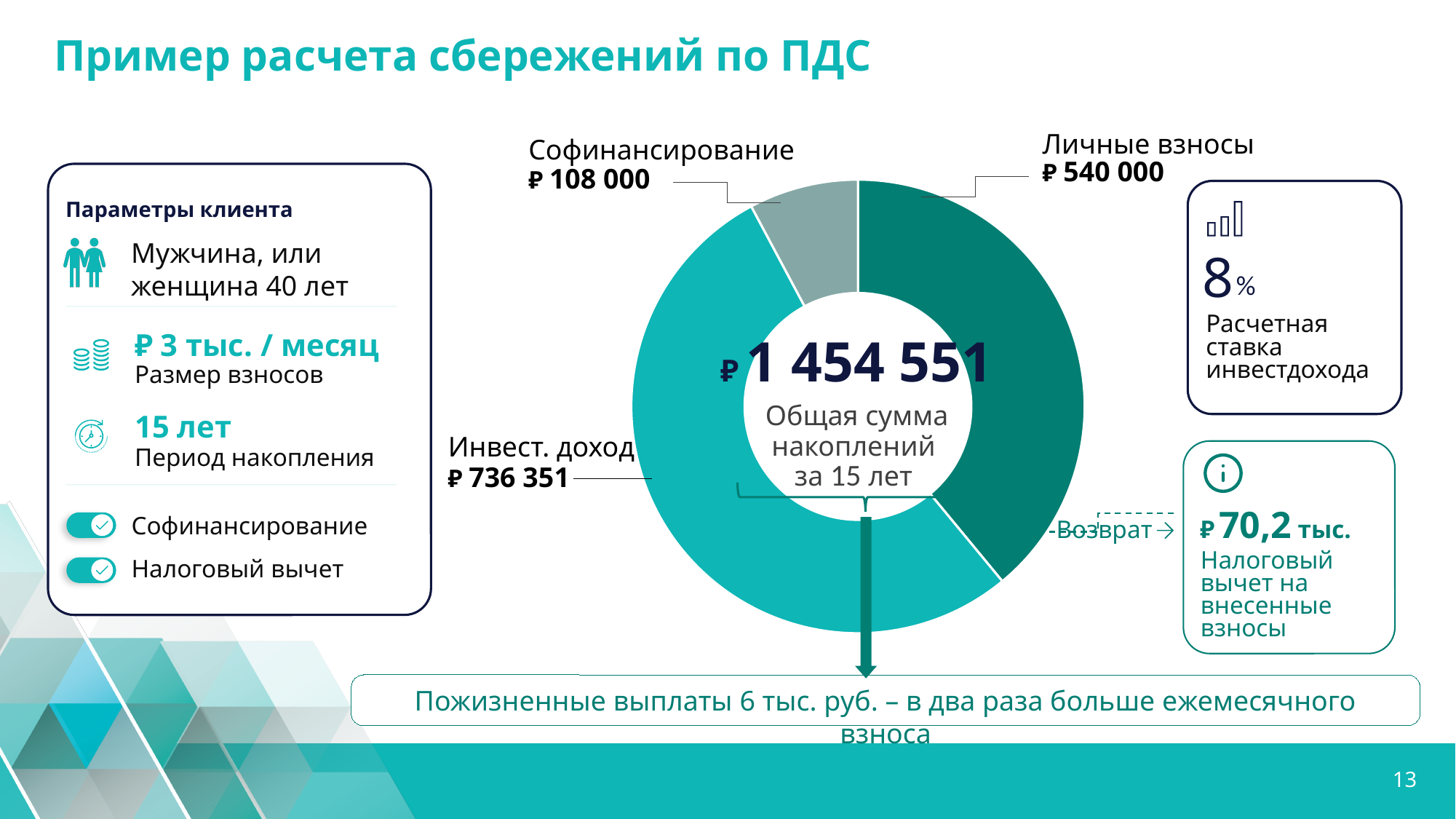
Which segment of the donut chart is the largest? Инвест. доход What is the value of the "Софинансирование" segment? ₽ 108 000 What is the value of the "Личные взносы" segment? ₽ 540 000 What is the difference between "Личные взносы" and "Софинансирование"? ₽ 432 000 What does the text in the centre of the donut chart say the total represents? Общая сумма накоплений за 15 лет How many segments does the donut chart have? 3 What is the difference between "Инвест. доход" and "Личные взносы"? ₽ 196 351 What type of chart is shown on the slide? Pie (donut) chart Which segment of the donut chart is the smallest? Софинансирование Which is larger: "Инвест. доход" or "Личные взносы"? Инвест. доход What total is printed in the centre of the donut chart? ₽ 1 454 551 What is the value of the "Инвест. доход" segment? ₽ 736 351